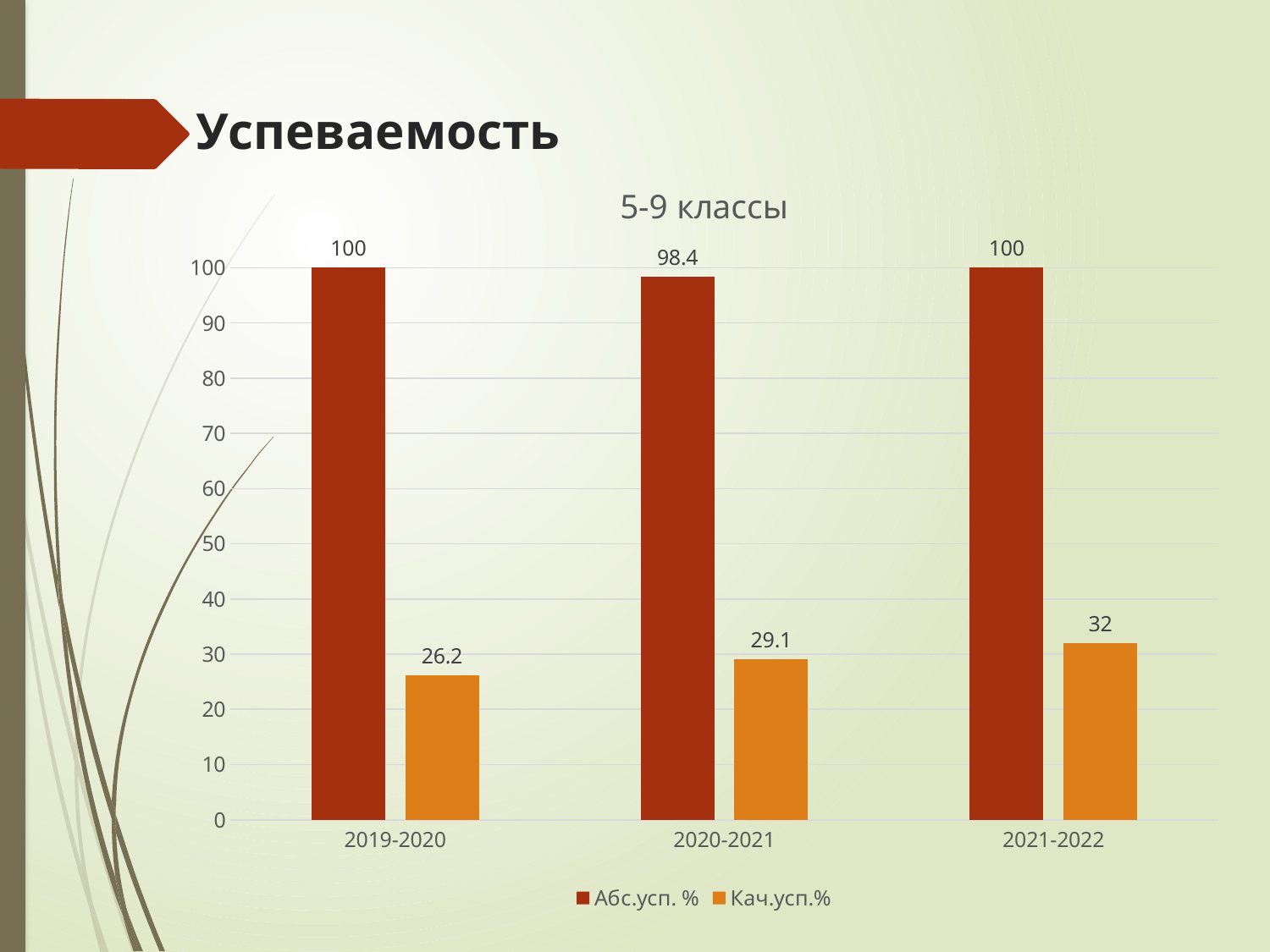
What is the value of Кач.усп.% for 2019-2020? 26.2 What kind of chart is shown on the slide? bar chart Which is larger: Кач.усп.% for 2020-2021 or Кач.усп.% for 2019-2020? 2020-2021 What is the difference between the Кач.усп.% values for 2021-2022 and 2019-2020? 5.8 What is the value of Кач.усп.% for 2021-2022? 32 Which year has the lowest Абс.усп. % value? 2020-2021 Which year has the highest Кач.усп.% value? 2021-2022 What is the value of Абс.усп. % for 2020-2021? 98.4 How many series does the legend list? 2 How many year categories are shown on the x axis? 3 Is the value of Кач.усп.% for 2020-2021 greater or less than 40? less What is the title of the chart? 5-9 классы